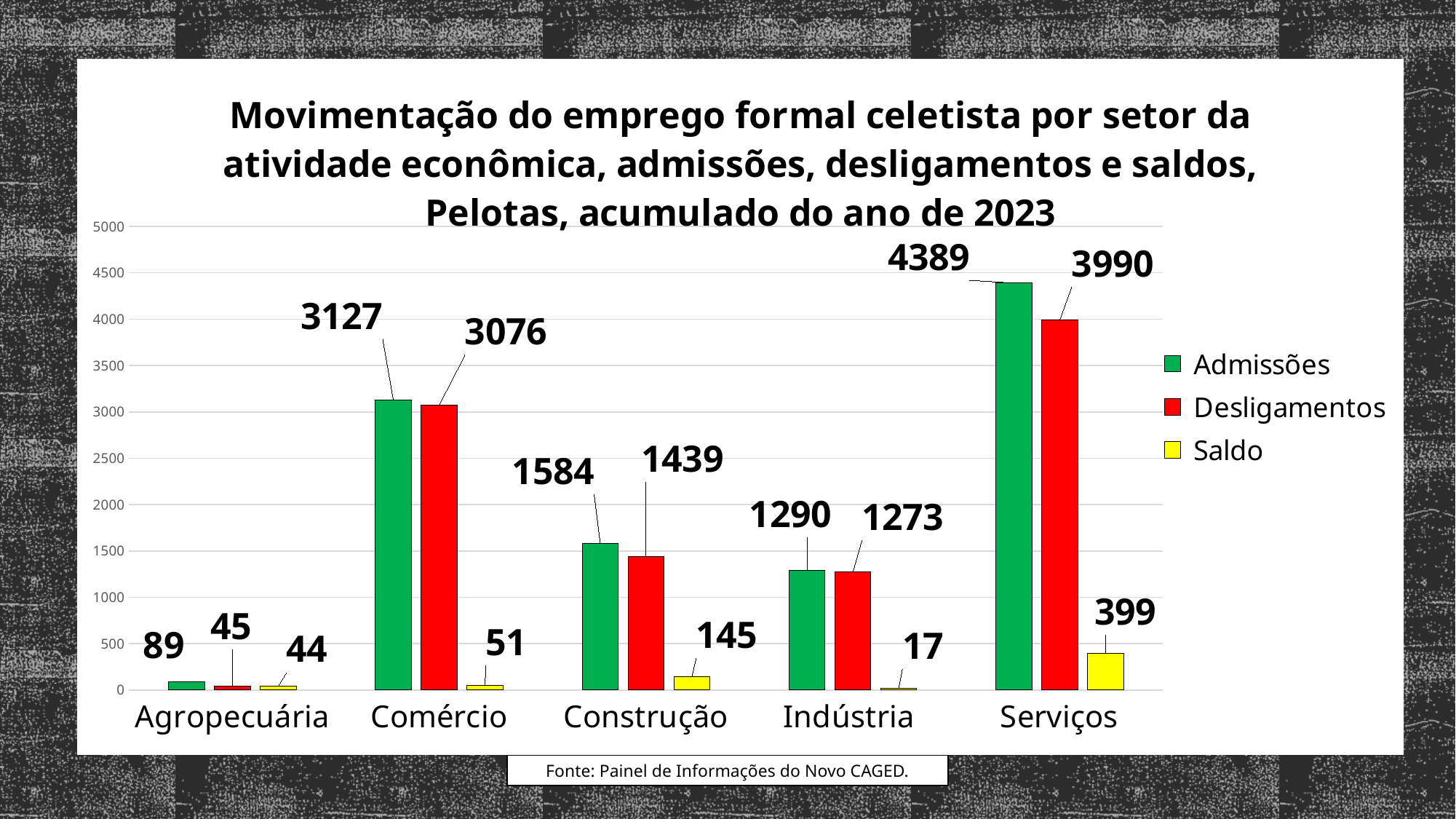
Which is larger: the Admissões value for Construção or the Admissões value for Indústria? Construção Which sector has the highest Admissões value? Serviços Is the Desligamentos value for Serviços greater or less than 3500? greater What is the Admissões value for Serviços? 4389 How many series does the legend list? 3 What is the difference between Admissões and Desligamentos for Comércio? 51 What is the Desligamentos value for Construção? 1439 What is the difference between the Saldo for Serviços and the Saldo for Construção? 254 How many sectors are shown on the x axis? 5 What is the Saldo value for Indústria? 17 Which sector has the lowest Desligamentos value? Agropecuária What kind of chart is shown on the slide? Bar chart